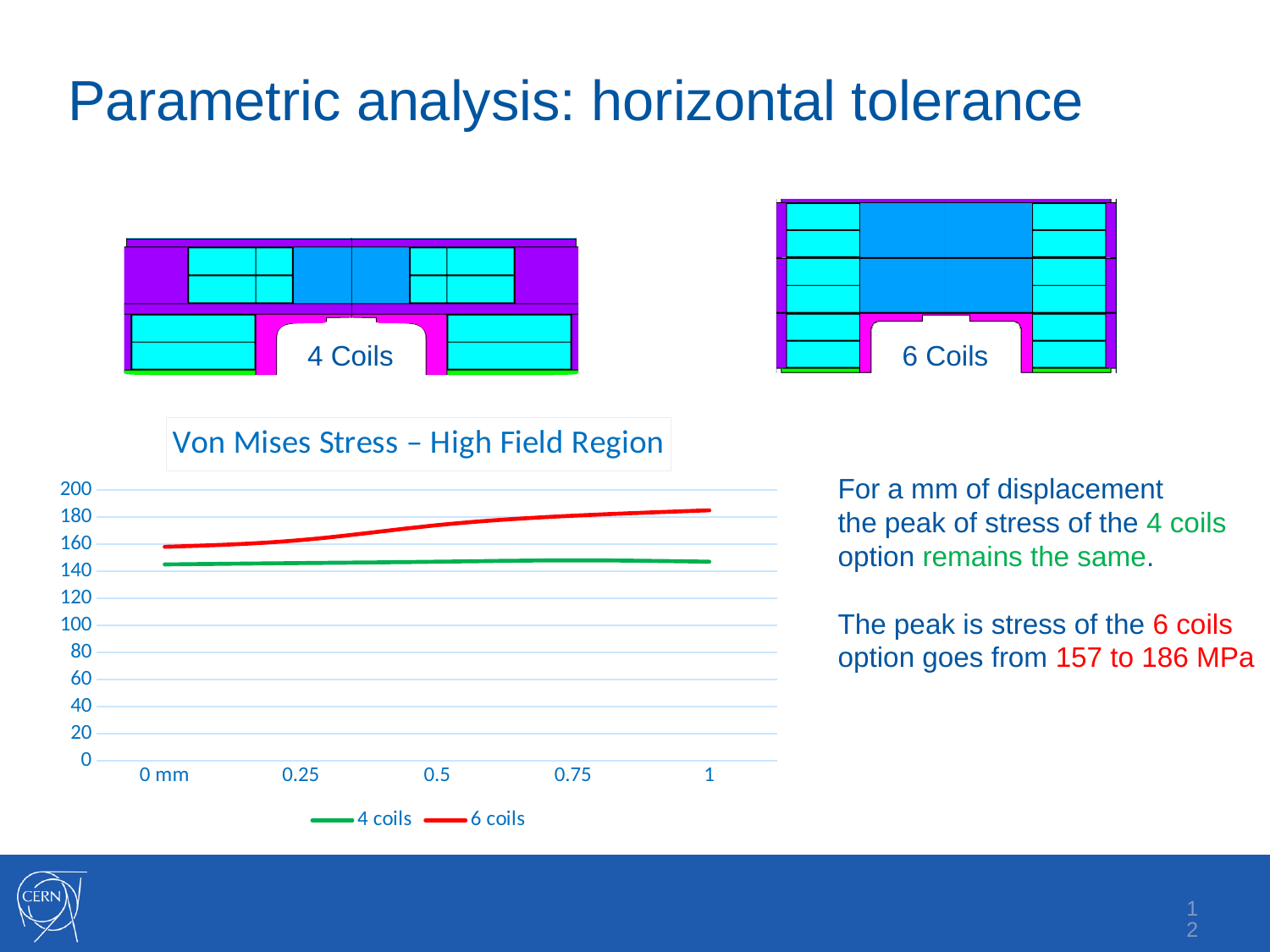
In the Von Mises Stress chart, is the value for 6 coils at a displacement of 1 greater or less than 180? greater In the Von Mises Stress chart, which series is higher at a displacement of 1, 4 coils or 6 coils? 6 coils In the Von Mises Stress chart, does the 6 coils series rise or fall as displacement increases from 0 mm to 1? rise How many points are labelled along the x axis of the Von Mises Stress chart? 5 In the Von Mises Stress chart, which series reaches the highest stress value? 6 coils What colour is the 6 coils line in the Von Mises Stress chart? red In the Von Mises Stress chart, does the 4 coils series change noticeably or stay roughly flat from 0 mm to 1? stays roughly flat In the Von Mises Stress chart, is the value for 6 coils at 0 mm greater or less than 140? greater How many series does the legend of the Von Mises Stress chart list? 2 What kind of chart is shown under the title "Von Mises Stress – High Field Region"? line chart In the Von Mises Stress chart, is the value for 4 coils at a displacement of 1 greater or less than 160? less